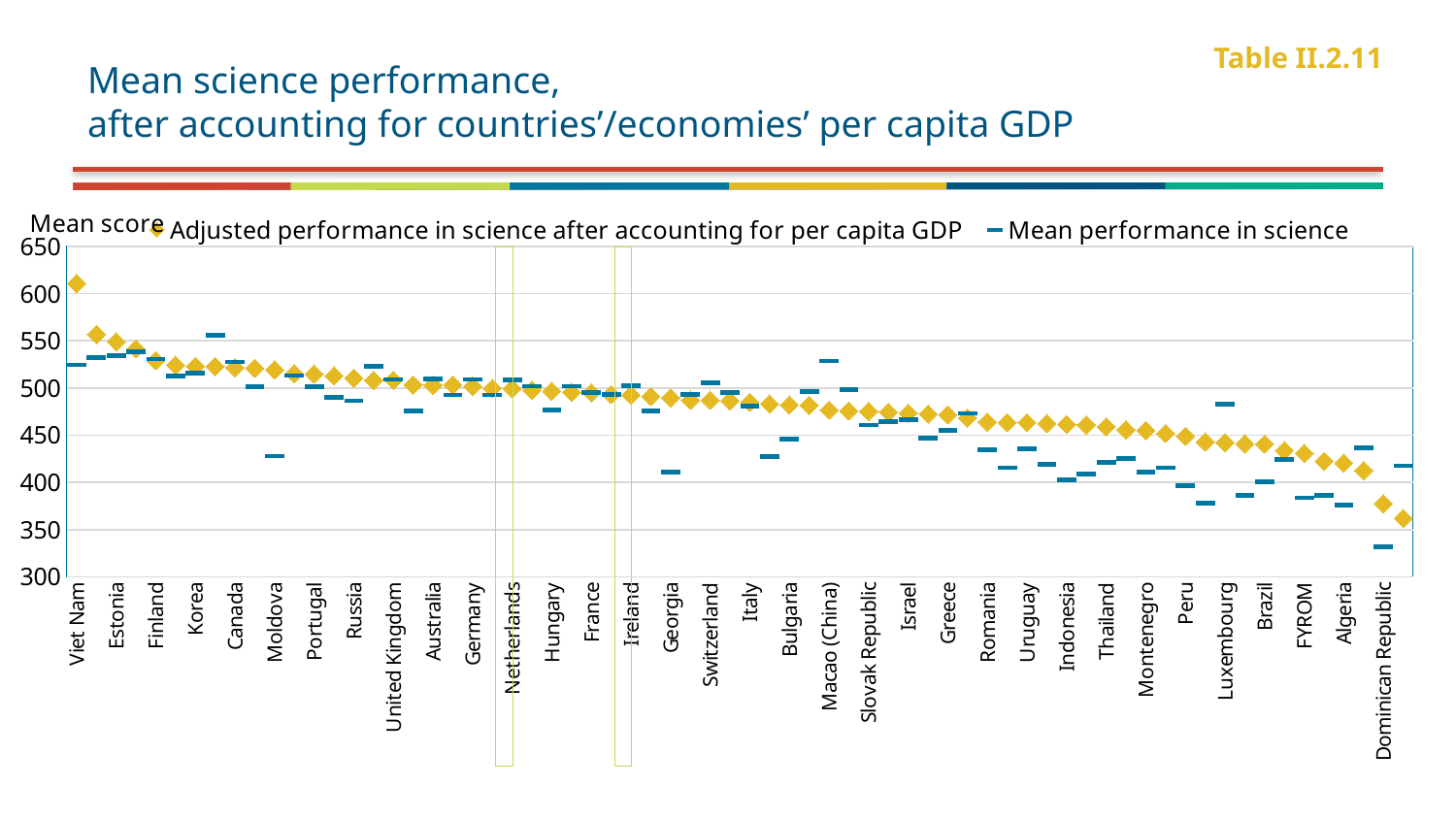
Which country has the highest adjusted performance in science after accounting for per capita GDP? Viet Nam Do the adjusted performance values rise or fall from left to right along the x axis? fall How many series does the legend list? 2 Is the mean performance in science for the Dominican Republic greater or less than 350? less Is the adjusted performance in science for Viet Nam greater or less than 600? greater Which two countries are highlighted with boxes on the chart? Netherlands and Ireland For Luxembourg, which is larger: the adjusted performance in science or the mean performance in science? mean performance in science What kind of chart is shown on the slide? scatter chart For Viet Nam, which is larger: the adjusted performance in science or the mean performance in science? adjusted performance in science Is the mean performance in science for Moldova greater or less than 450? less